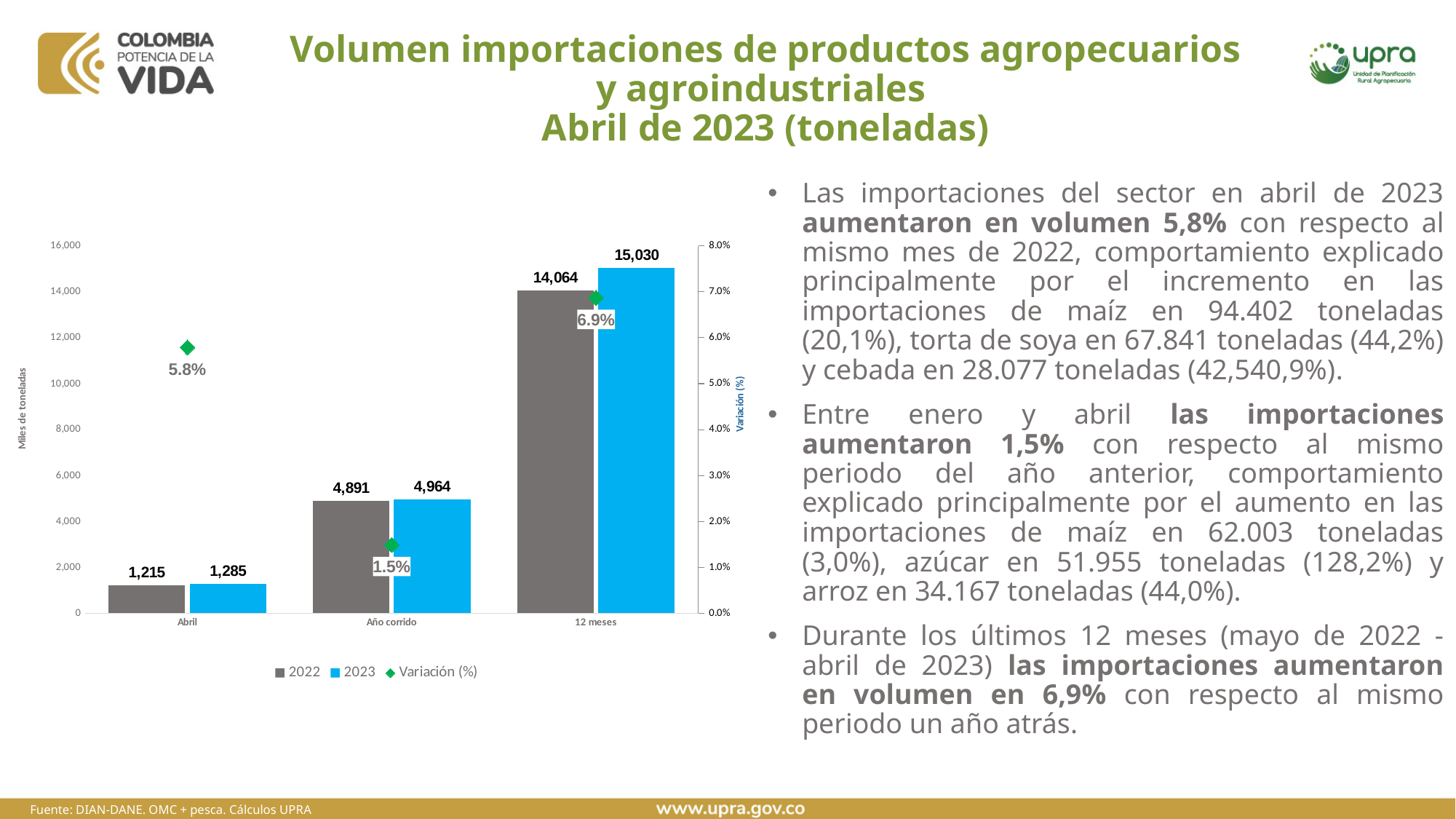
How many categories are shown on the x axis? 3 Which category has the lowest Variación (%) value? Año corrido Which is larger for Abril, the 2022 value or the 2023 value? 2023 What is the Variación (%) value for Año corrido? 1.5% What is the 2022 value for Año corrido? 4,891 What kind of chart is this? Bar chart with a line/marker series What is the 2022 value for 12 meses? 14,064 What is the difference between the 2023 and 2022 values for 12 meses? 966 What is the label of the left vertical axis? Miles de toneladas Which category has the highest 2023 value? 12 meses How many series does the legend list? 3 What is the 2023 value for Abril? 1,285